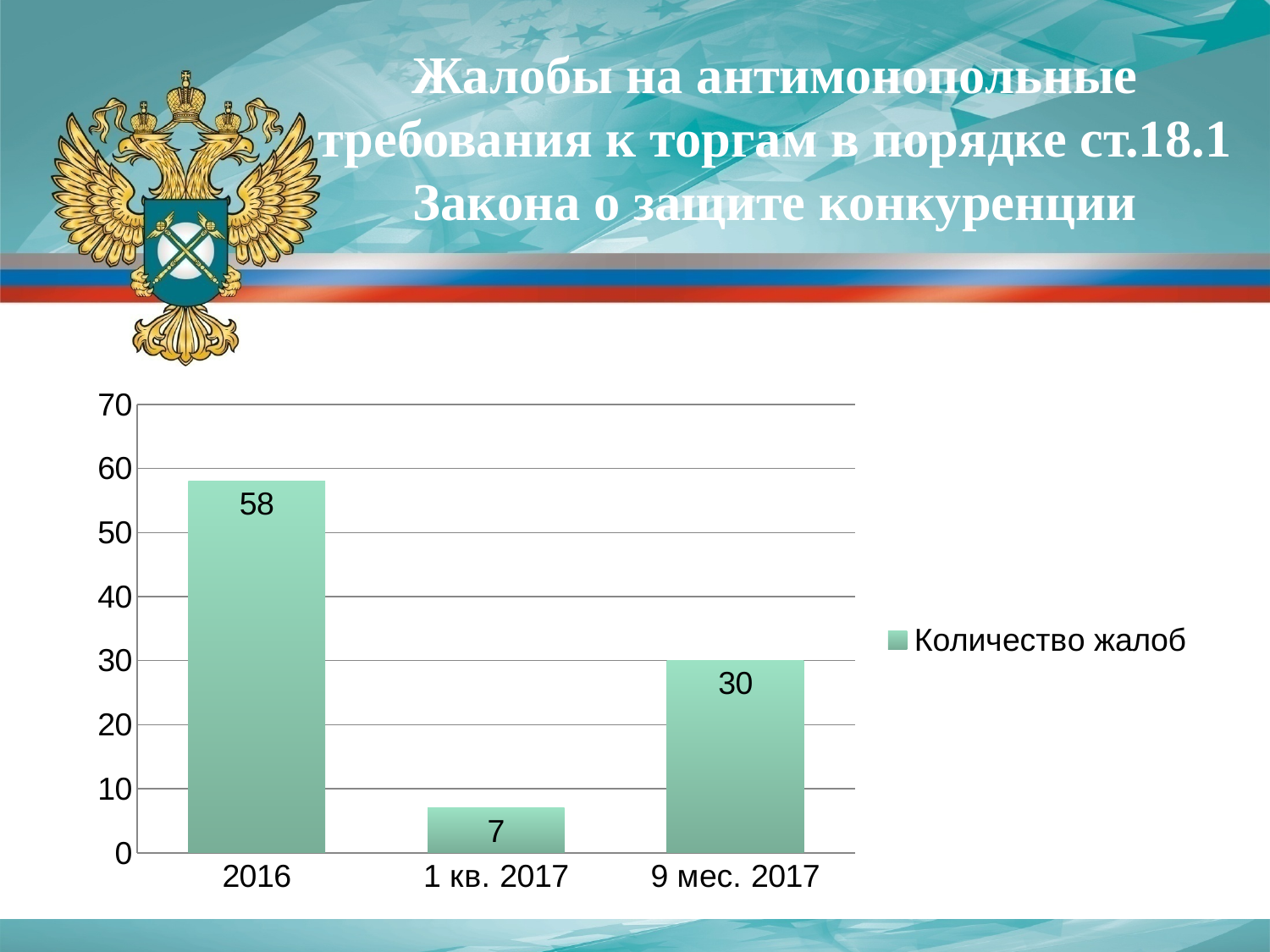
Which category has the highest value? 2016 How many series does the legend list? 1 What is the value for 9 мес. 2017? 30 How many categories are shown on the x axis? 3 What is the difference between the values for 2016 and 9 мес. 2017? 28 What is the value for 1 кв. 2017? 7 What is the value for 2016? 58 Which category has the lowest value? 1 кв. 2017 What kind of chart is shown on the slide? bar chart Is the value for 2016 greater or less than 50? greater What is the difference between the values for 9 мес. 2017 and 1 кв. 2017? 23 Which is larger, the value for 2016 or the value for 9 мес. 2017? 2016